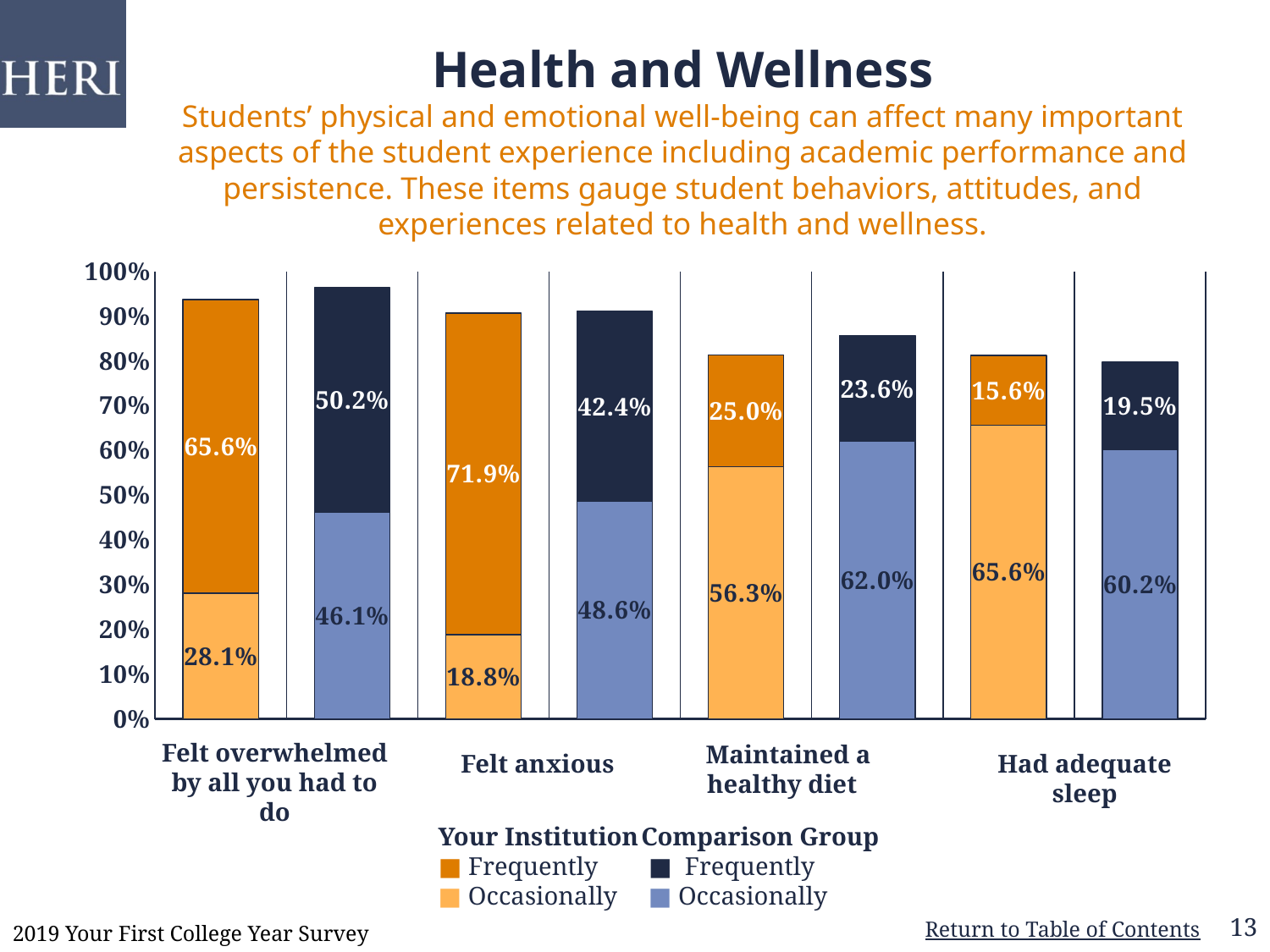
What percentage of students at Your Institution reported frequently feeling anxious? 71.9% For 'Felt anxious', which is larger: Your Institution's 'Occasionally' value or the Comparison Group's 'Occasionally' value? Comparison Group How many categories are shown on the x axis of the chart? 4 Which category has the highest 'Frequently' value for Your Institution? Felt anxious What kind of chart is shown on the slide? Stacked bar chart What is the total of the stacked bar for the Comparison Group under 'Felt overwhelmed by all you had to do'? 96.3% How many series does the legend list? 4 What is the Comparison Group's 'Occasionally' value for 'Maintained a healthy diet'? 62.0% What is the total of the stacked bar for Your Institution under 'Maintained a healthy diet'? 81.3% What is the difference between Your Institution's and the Comparison Group's 'Frequently' values for 'Felt overwhelmed by all you had to do'? 15.4 percentage points Which category has the lowest 'Frequently' value for the Comparison Group? Had adequate sleep What is the 'Frequently' value for Your Institution under 'Had adequate sleep'? 15.6%